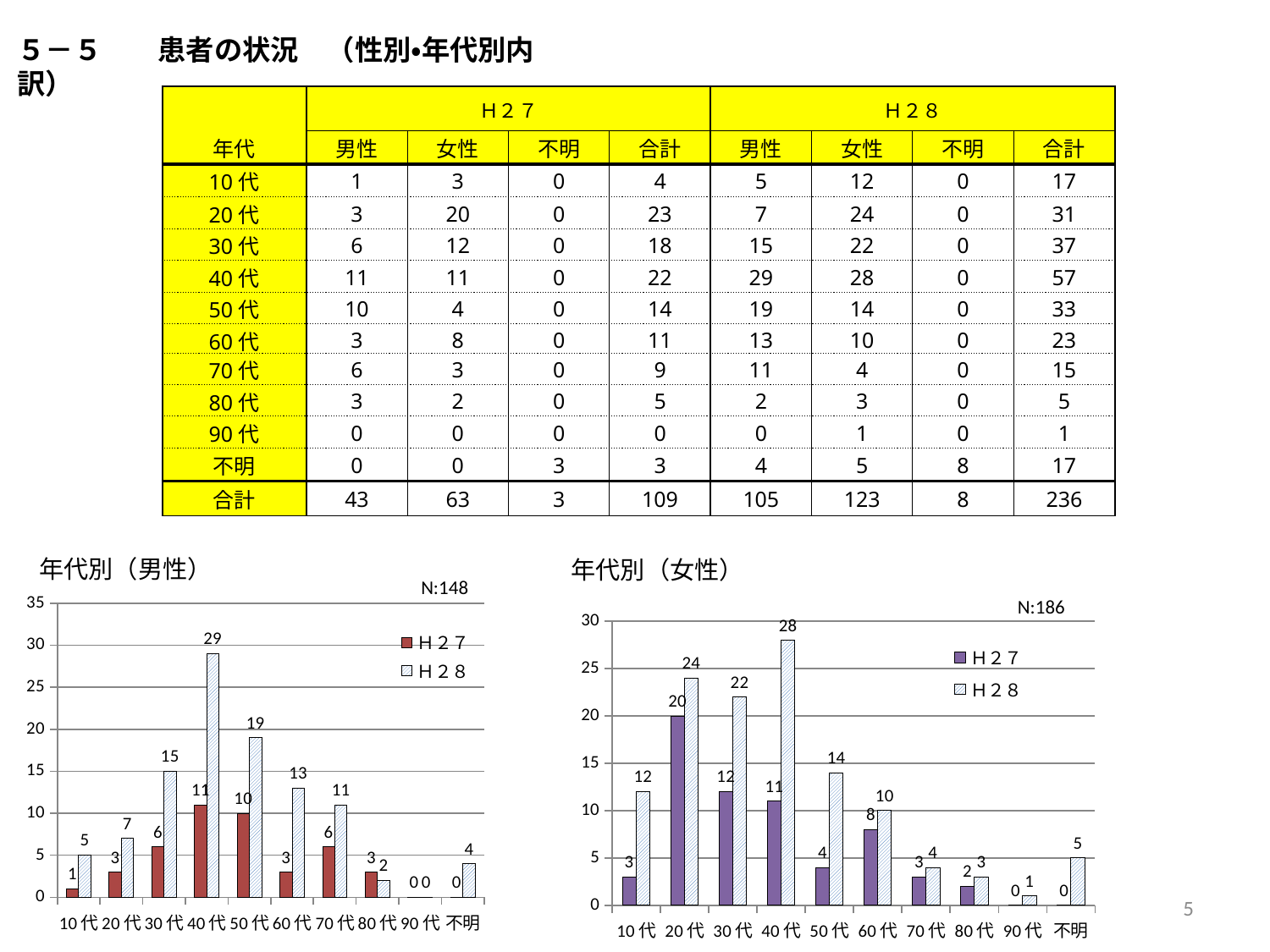
In the 年代別（女性） chart, what is the H27 value for 20代? 20 In the 年代別（男性） chart, what is the H27 value for 50代? 10 In the 年代別（男性） chart, which age category has the highest H28 value? 40代 In the 年代別（女性） chart, what is the H28 value for 40代? 28 In the 年代別（男性） chart, how many age categories are shown on the x axis? 10 What N value is shown on the 年代別（女性） chart? N:186 In the 年代別（男性） chart, how many series does the legend list? 2 In the 年代別（男性） chart, what is the difference between the H28 and H27 values for 30代? 9 What kind of chart is the 年代別（女性） chart? bar chart In the 年代別（女性） chart, which age category has the highest H27 value? 20代 In the 年代別（女性） chart, which is larger for 60代: the H27 value or the H28 value? H28 In the 年代別（男性） chart, what is the H28 value for 40代? 29